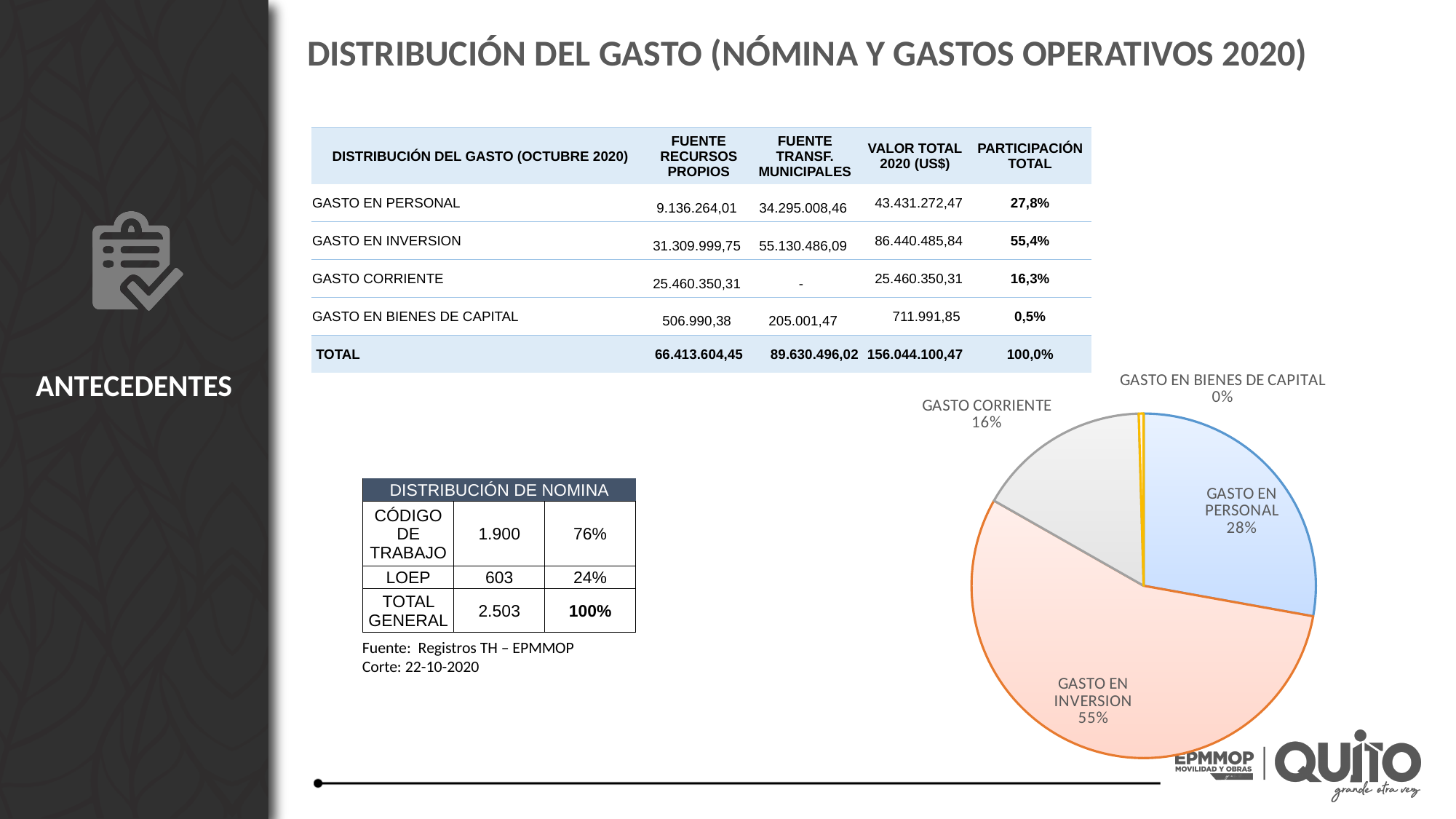
In the pie chart, what share is shown for GASTO EN PERSONAL? 28% In the pie chart, what share is shown for GASTO EN BIENES DE CAPITAL? 0% In the pie chart, what is the difference in percentage points between GASTO EN PERSONAL and GASTO CORRIENTE? 12 How many slices does the pie chart have? 4 What colour is the GASTO EN INVERSION slice in the pie chart? light orange What kind of chart is shown on the slide? pie chart In the pie chart, what share is shown for GASTO EN INVERSION? 55% In the pie chart, which is larger: GASTO EN PERSONAL or GASTO CORRIENTE? GASTO EN PERSONAL Which slice of the pie chart is the largest? GASTO EN INVERSION Which slice of the pie chart is the smallest? GASTO EN BIENES DE CAPITAL In the pie chart, what is the difference in percentage points between GASTO EN INVERSION and GASTO EN PERSONAL? 27